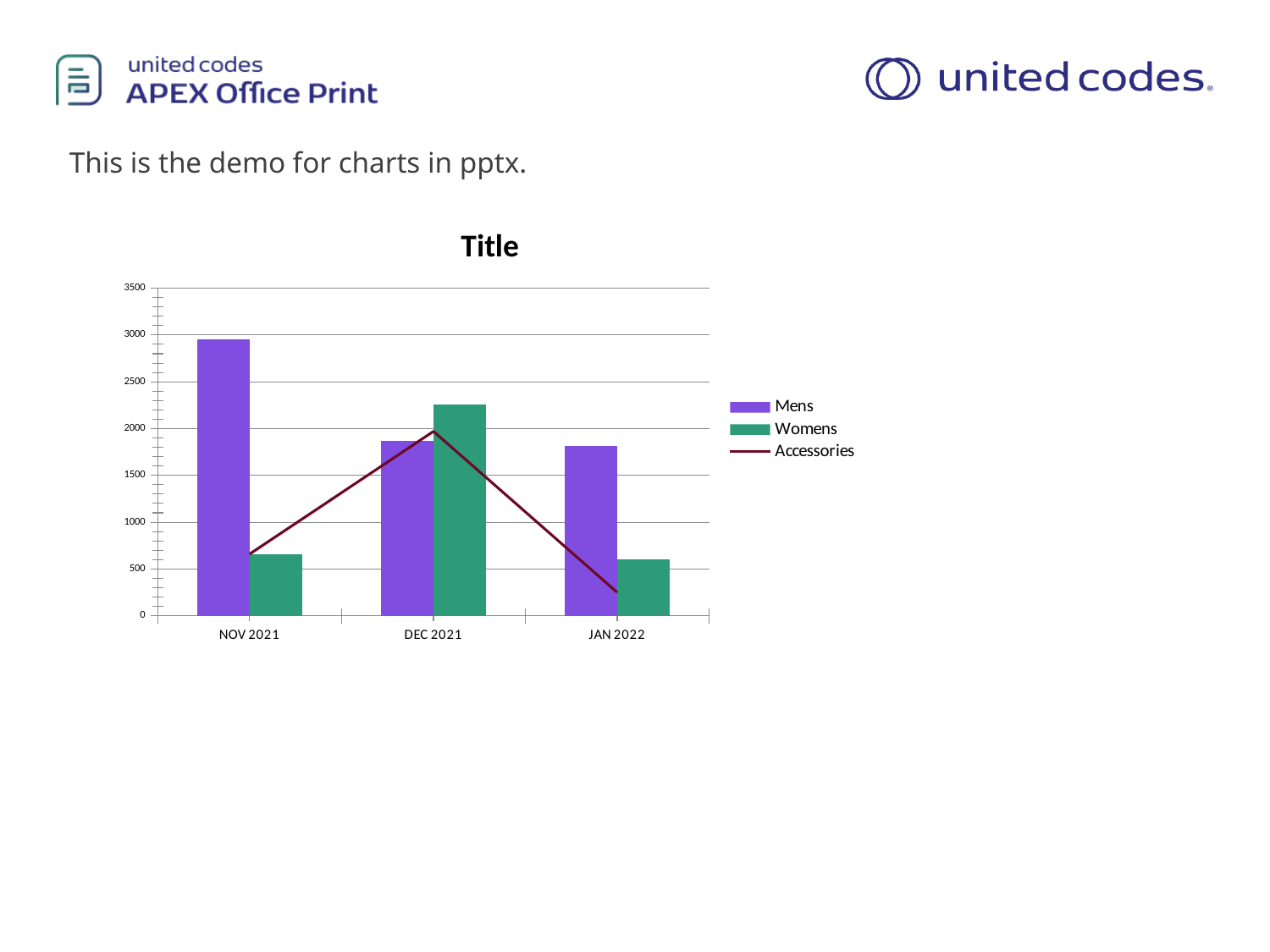
In NOV 2021, which is larger, Mens or Womens? Mens How many categories are shown on the x axis? 3 Which series is drawn as a line rather than bars? Accessories In DEC 2021, which is larger, Mens or Womens? Womens What kind of chart is shown on the slide? A bar chart with a line series Is the Womens value for NOV 2021 greater or less than 1000? less Is the Accessories value for JAN 2022 greater or less than 500? less How many series does the legend list? 3 In which category is the Accessories value lowest? JAN 2022 Is the Mens value for NOV 2021 greater or less than 2500? greater In which category is the Womens value highest? DEC 2021 In which category is the Mens value highest? NOV 2021